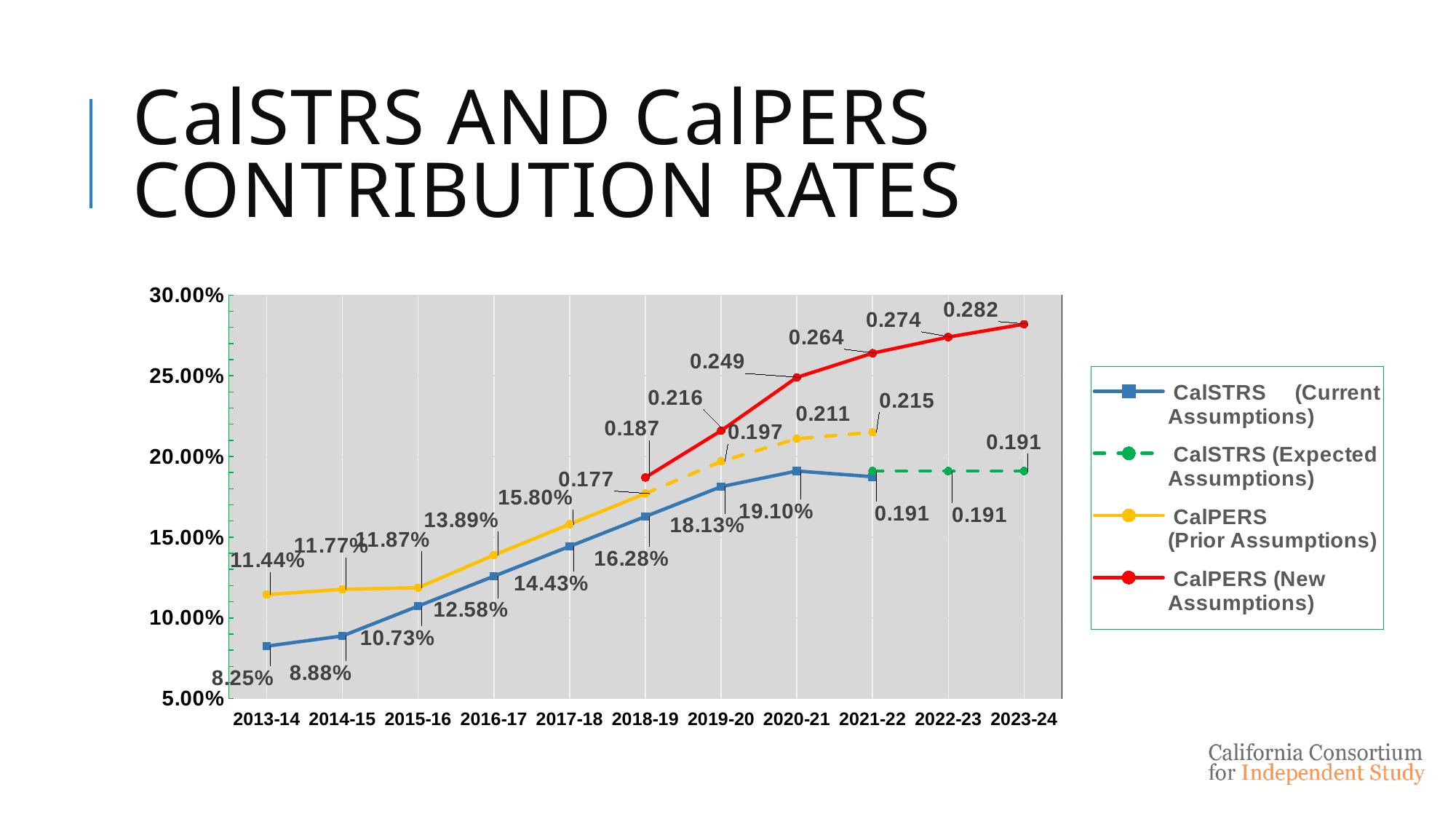
In which year is the CalSTRS (Current Assumptions) rate lowest? 2013-14 How many series does the legend list? 4 How many fiscal years are shown on the x axis? 11 What is the CalSTRS (Current Assumptions) contribution rate for 2013-14? 8.25% What is the CalPERS (New Assumptions) value for 2023-24? 0.282 In which year does the CalPERS (New Assumptions) series reach its highest value? 2023-24 What is the CalPERS (Prior Assumptions) contribution rate for 2016-17? 13.89% What is the difference between the CalPERS (New Assumptions) values for 2023-24 and 2022-23? 0.008 Does the CalPERS (New Assumptions) series rise or fall from 2018-19 to 2023-24? Rise What kind of chart is shown on the slide? Line chart In 2019-20, which is higher: CalPERS (New Assumptions) or CalPERS (Prior Assumptions)? CalPERS (New Assumptions) What colour is the CalPERS (New Assumptions) line? Red